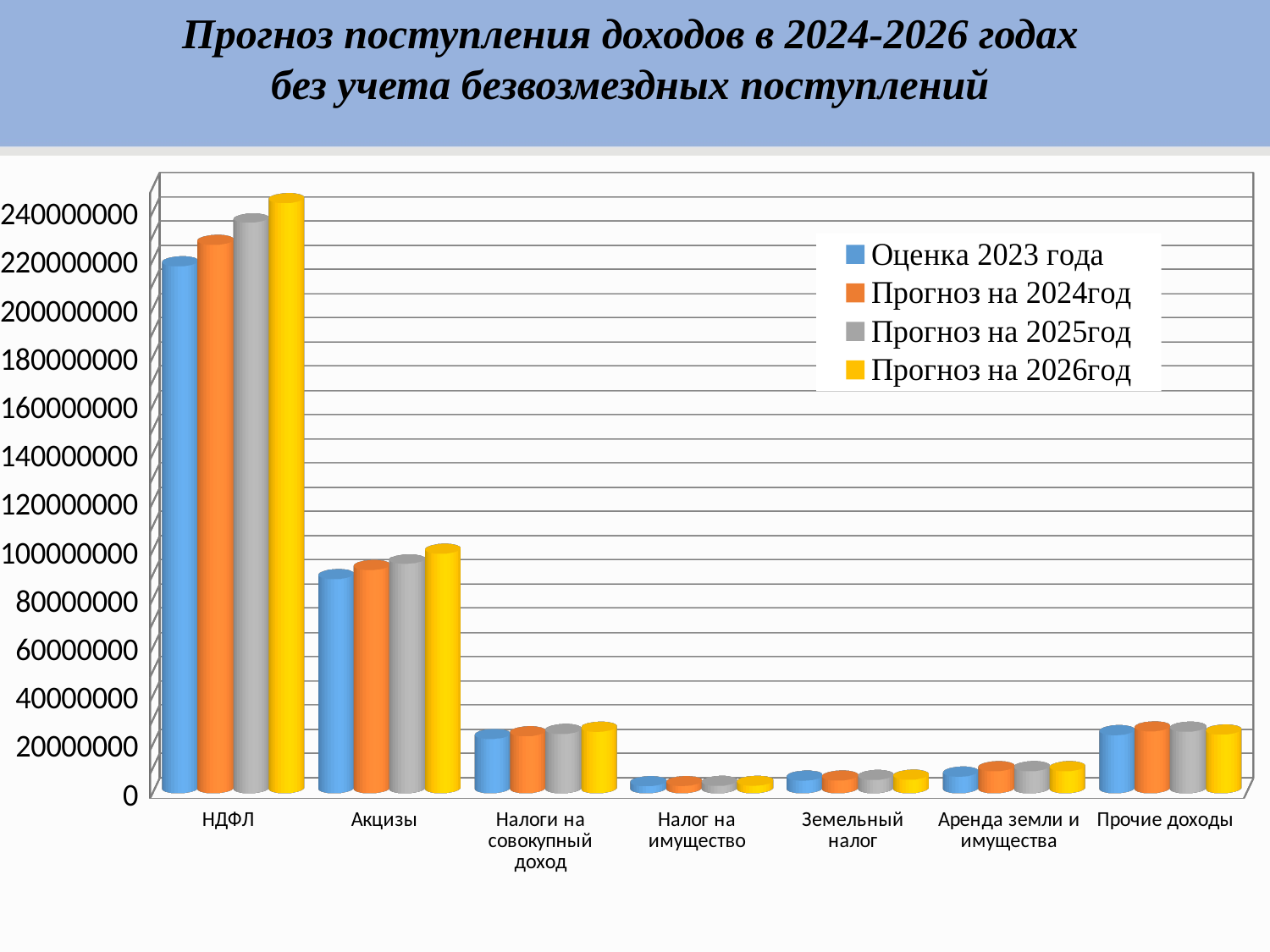
For НДФЛ, do the values rise or fall from Оценка 2023 года to Прогноз на 2026год? rise Is the value for НДФЛ in the series Оценка 2023 года greater or less than 200000000? greater Is the value for Прочие доходы in the series Прогноз на 2024год greater or less than 20000000? greater Which series is shown in yellow in the legend? Прогноз на 2026год In the series Оценка 2023 года, which is larger: НДФЛ or Акцизы? НДФЛ Is the value for Акцизы in the series Оценка 2023 года greater or less than 100000000? less Which category has the highest values in the chart? НДФЛ What kind of chart is shown on the slide? bar chart Which category has the lowest values in the chart? Налог на имущество How many series does the legend list? 4 How many categories are shown on the x axis of the chart? 7